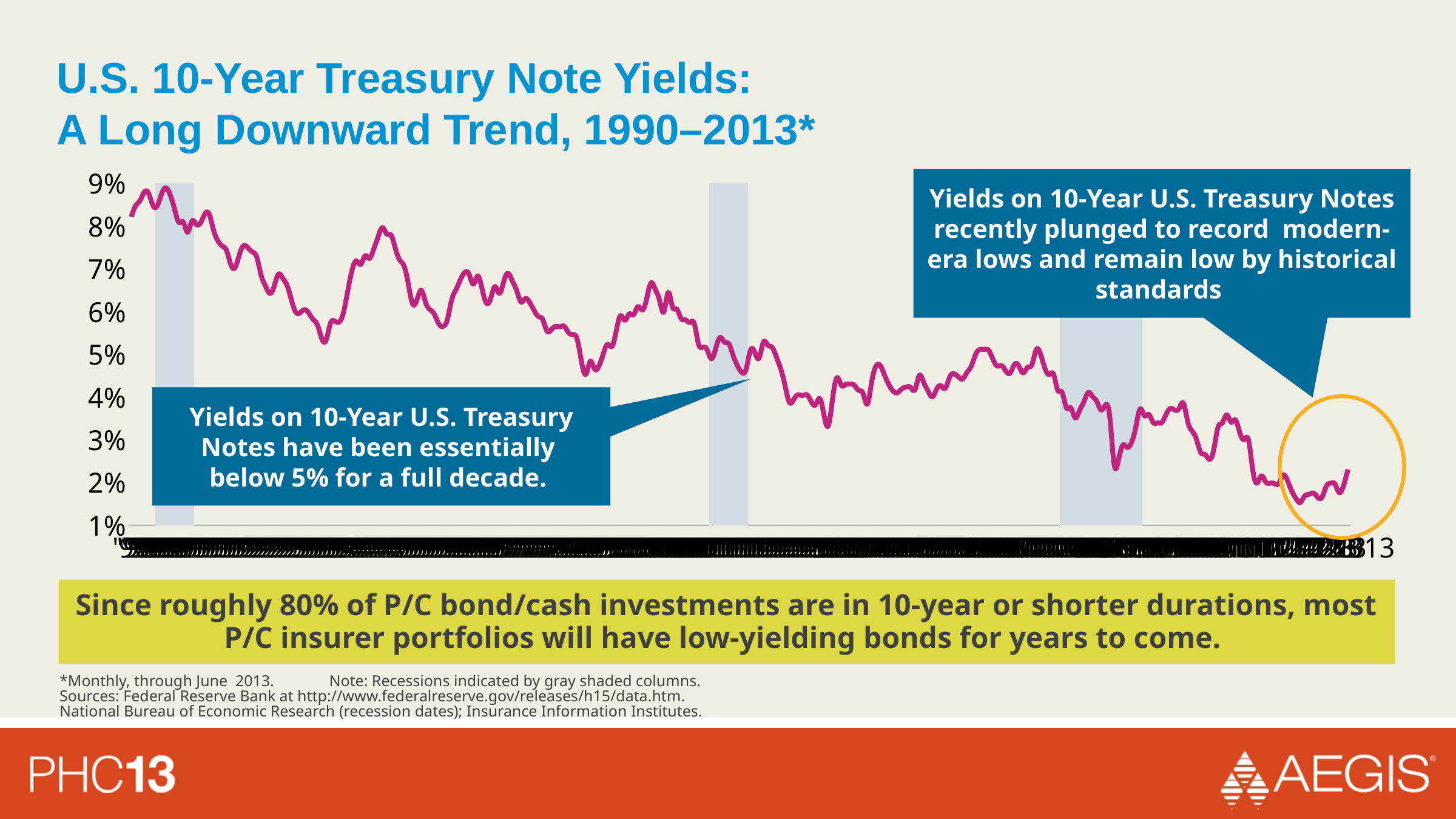
Is the yield at the start of the series in 1990 greater or less than 7%? greater Overall, do the 10-year Treasury yields rise or fall from 1990 to 2013 along the x axis? fall Is the lowest point of the yield line greater or less than 2%? less What is the title of the chart on the slide? U.S. 10-Year Treasury Note Yields: A Long Downward Trend, 1990–2013* How many gray shaded recession columns are shown on the chart? 3 Is the highest point of the yield line greater or less than 8%? greater What kind of chart is shown on the slide? line chart What is the highest value shown on the y axis of the chart? 9% Which is higher, the yield at the start of the series in 1990 or the yield at the end of the series in 2013? the start of the series in 1990